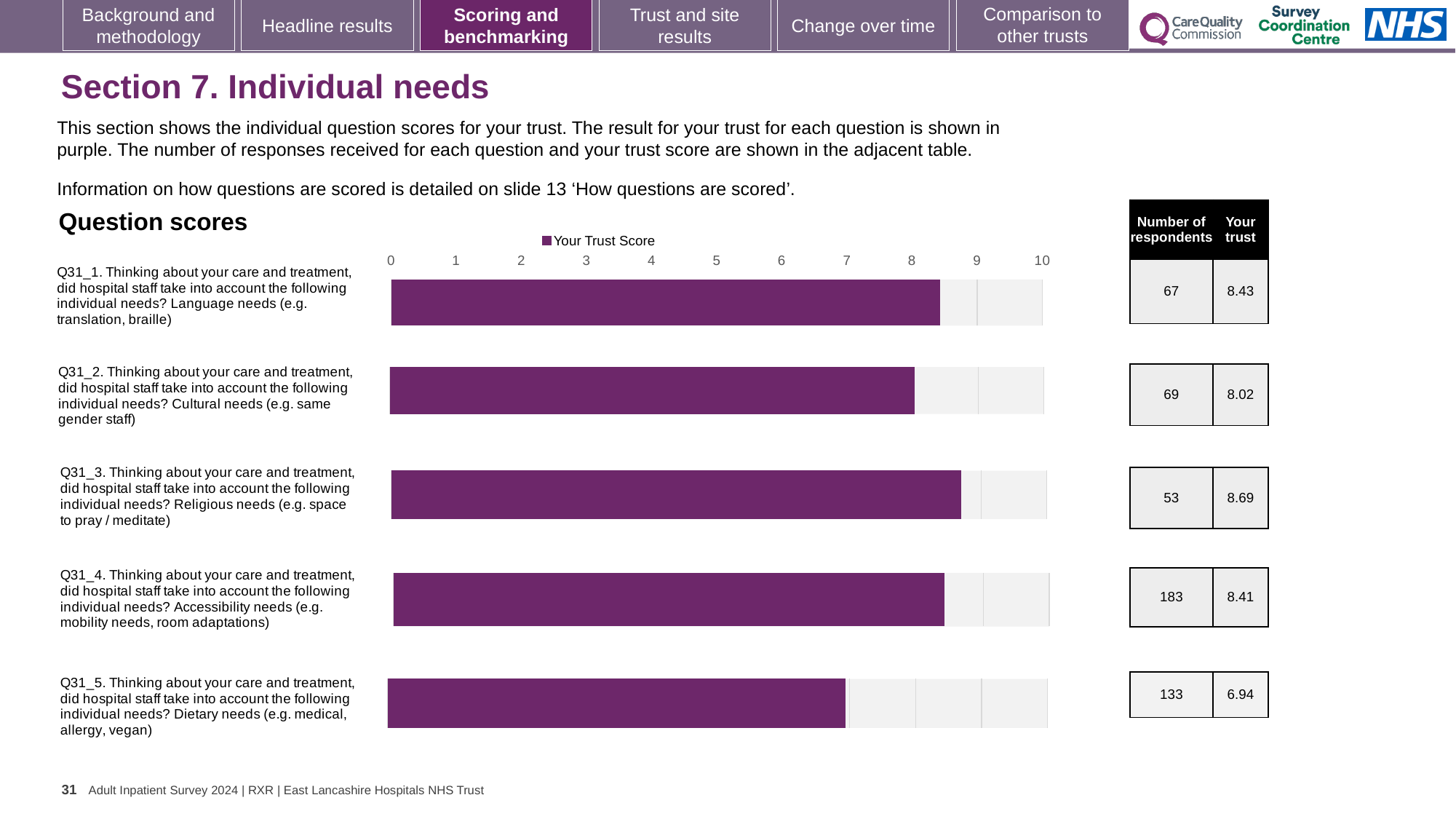
What is the trust score for Q31_3 (Religious needs)? 8.69 How many series does the chart legend list? 1 How many questions are plotted in the Question scores chart? 5 What kind of chart is used to show the question scores? Bar chart Which question has the highest trust score? Q31_3 (Religious needs) What is the difference between the trust scores for Q31_3 (Religious needs) and Q31_5 (Dietary needs)? 1.75 Is the trust score for Q31_5 (Dietary needs) greater or less than 8? less What is the trust score for Q31_1 (Language needs)? 8.43 What is the trust score for Q31_5 (Dietary needs)? 6.94 What is the name of the series shown in the chart legend? Your Trust Score Which question has the lowest trust score? Q31_5 (Dietary needs) Which has the larger trust score, Q31_2 (Cultural needs) or Q31_4 (Accessibility needs)? Q31_4 (Accessibility needs)